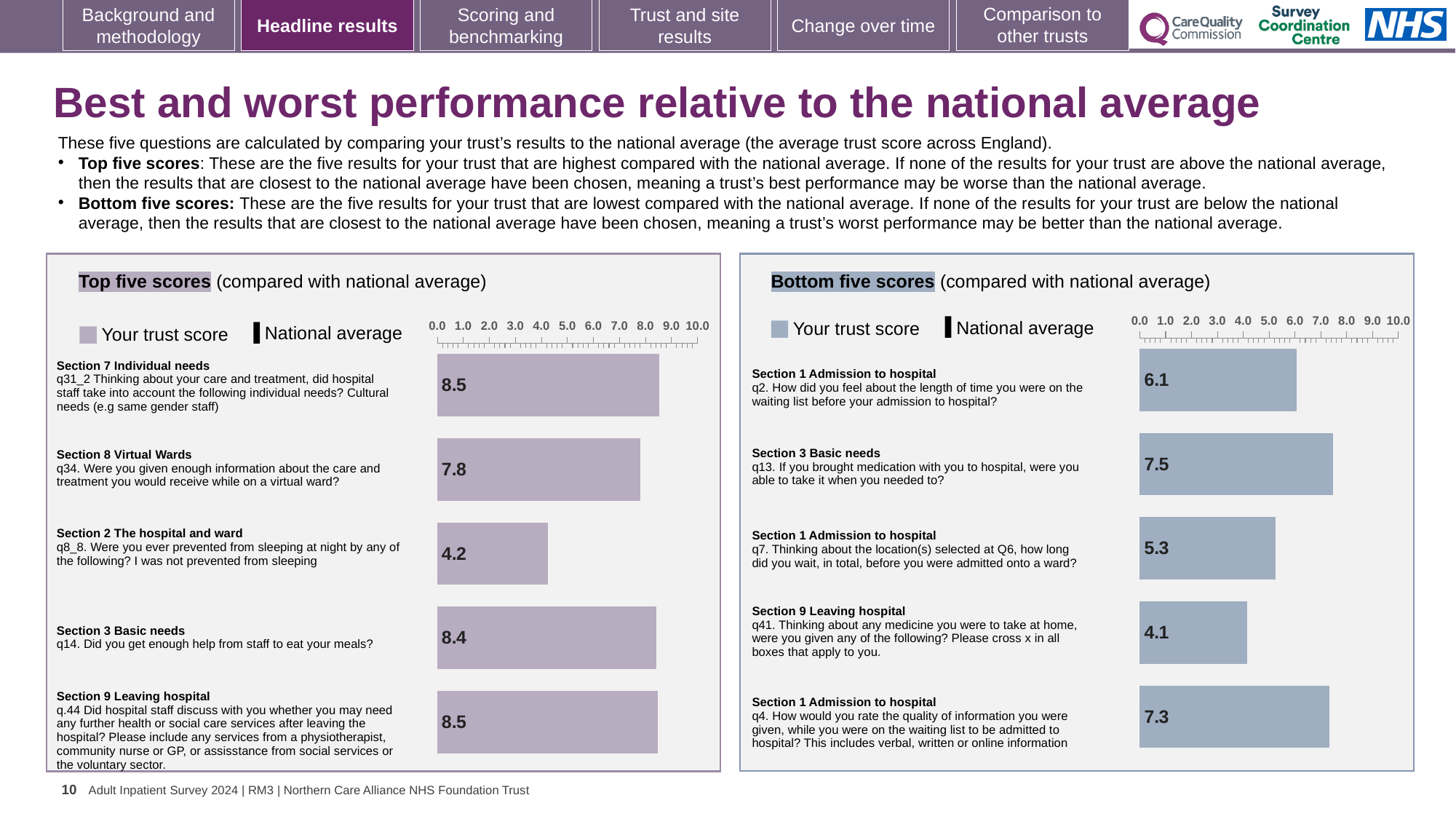
In the Bottom five scores chart, what is the trust score for q4 (quality of information while on the waiting list)? 7.3 In the Bottom five scores chart, is the trust score for q7 larger or smaller than the score for q13? smaller In the Top five scores chart, what is the difference between the trust scores for q31_2 and q8_8? 4.3 What type of chart is used in the Top five scores panel? Bar chart In the Top five scores chart, what is the trust score for q14 (enough help from staff to eat your meals)? 8.4 In the Top five scores chart, which question has the lowest trust score? q8_8 (not prevented from sleeping) In the Bottom five scores chart, what is the difference between the trust scores for q13 and q41? 3.4 In the Bottom five scores chart, which question has the lowest trust score? q41 (medicine to take at home) In the Bottom five scores chart, what is the trust score for q2 (length of time on the waiting list)? 6.1 In the Top five scores chart, how many questions are plotted? 5 In the Top five scores chart, what is the trust score for q34 (information about care and treatment on a virtual ward)? 7.8 In the Bottom five scores chart, which question has the highest trust score? q13 (able to take medication brought to hospital)